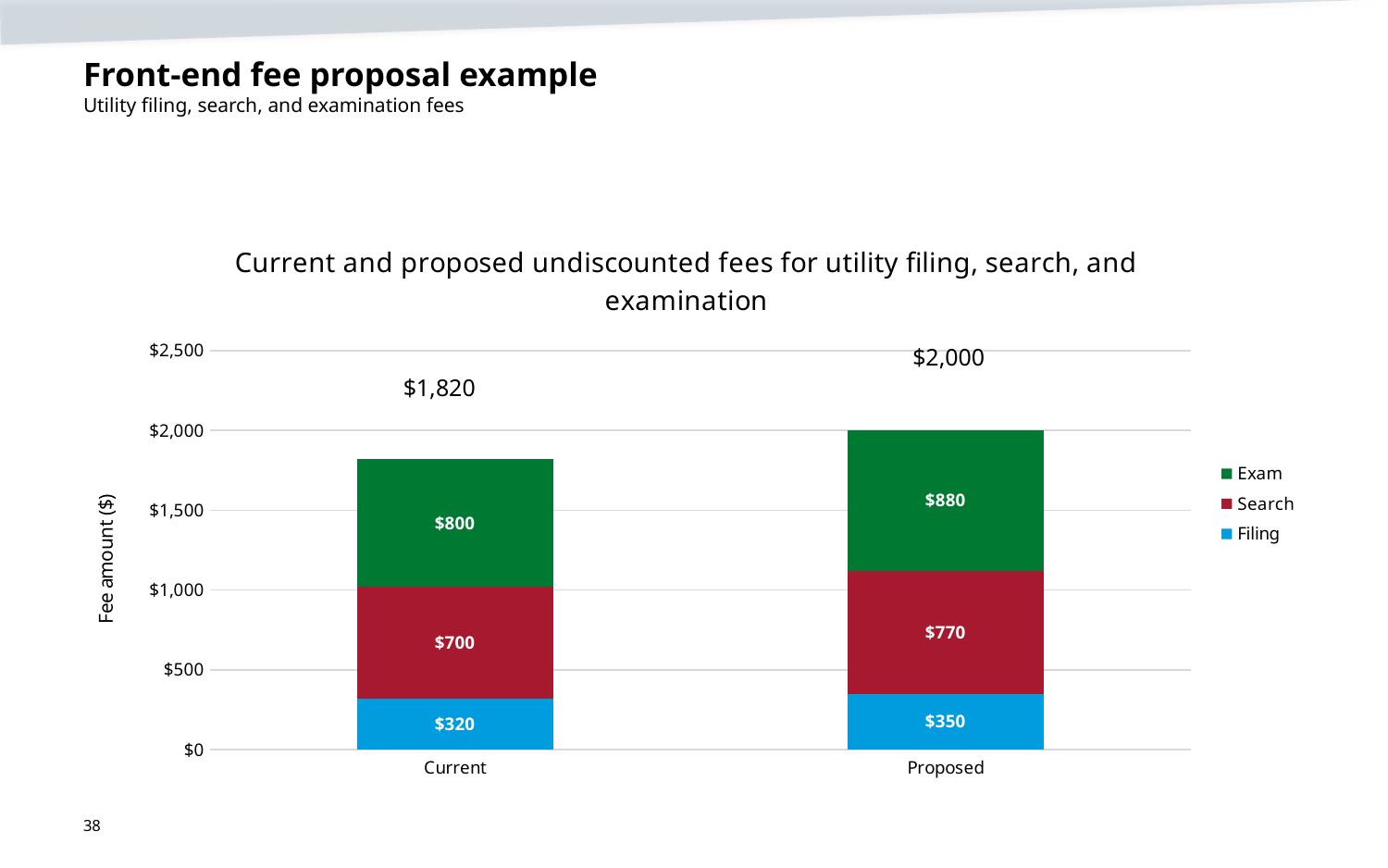
What is the Search fee for the Proposed bar? $770 What kind of chart is shown? Stacked bar chart What is the Filing fee for the Current bar? $320 How many categories are shown on the x axis? 2 What is the difference between the Proposed and Current Search fees? $70 What is the total of the Proposed stacked bar? $2,000 Which category has the higher Exam fee, Current or Proposed? Proposed How many series does the legend list? 3 What is the total of the Current stacked bar? $1,820 What is the difference between the Proposed and Current totals? $180 What is the Exam fee for the Proposed bar? $880 Which series has the lowest value in the Current bar? Filing